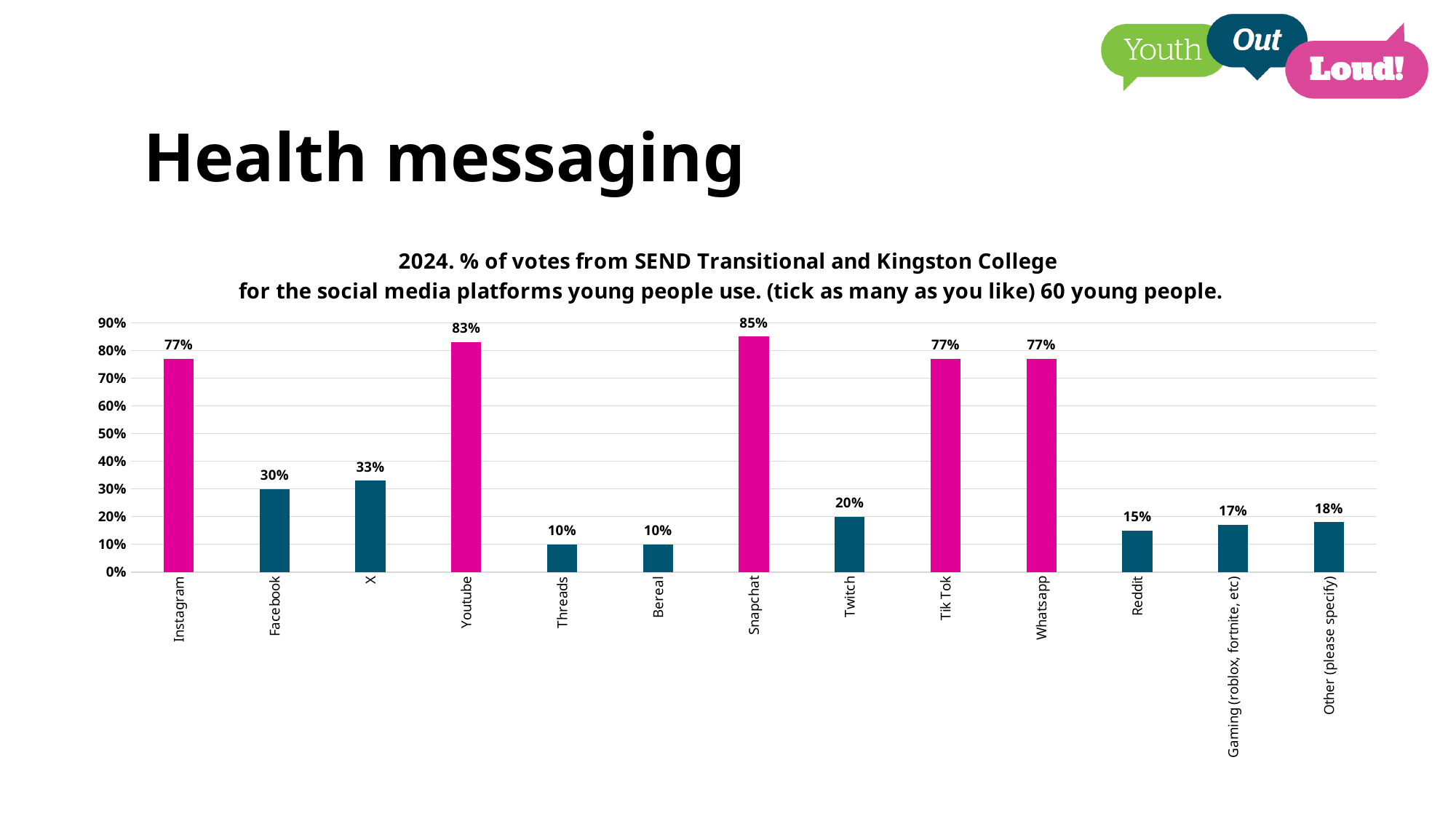
Is the value for Reddit greater or less than 20%? less Which social media platform received the highest percentage of votes? Snapchat What percentage of votes did Snapchat receive? 85% How many categories are shown on the x axis of the chart? 13 Which has a higher value, X or Twitch? X Which two platforms share the lowest value of 10%? Threads and Bereal What is the difference between the values for Youtube and Instagram? 6% What is the value for Gaming (roblox, fortnite, etc)? 17% What percentage of votes did Facebook receive? 30% How many platforms have a value of 77%? 3 What colour are the bars for the platforms with the highest values, such as Snapchat and Youtube? Pink What kind of chart is shown on the slide? Bar chart